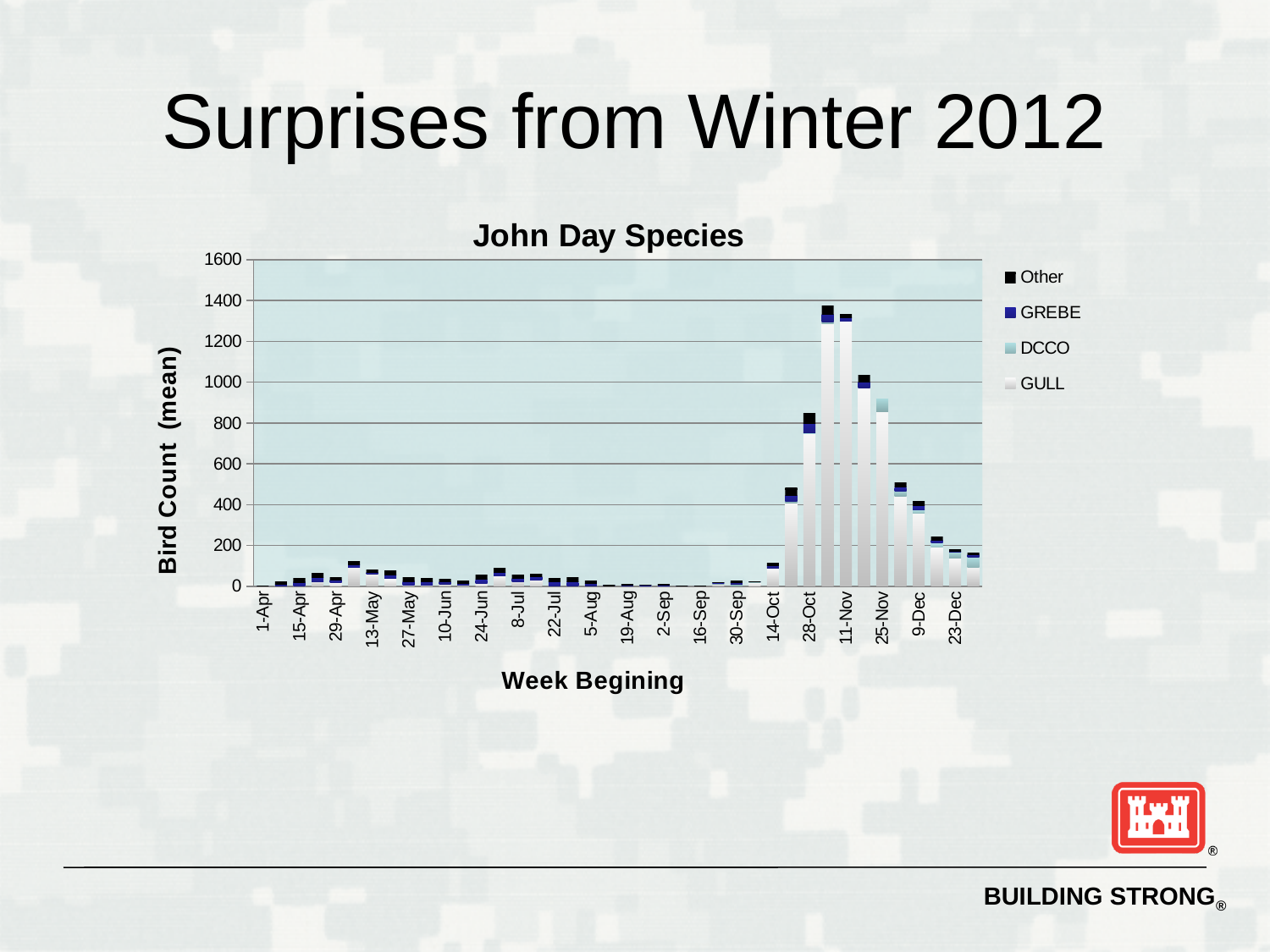
Is the total bird count for the week beginning 11-Nov greater or less than 1200? greater Which week has the larger total bird count, 11-Nov or 14-Oct? 11-Nov Is the total bird count for the week beginning 23-Dec greater or less than 400? less How many series does the legend of the John Day Species chart list? 4 Is the total bird count for the week beginning 14-Oct greater or less than 200? less What is the title of the chart? John Day Species Which week has the larger total bird count, 28-Oct or 9-Dec? 28-Oct Do the total bird counts rise or fall from 11-Nov to 23-Dec? fall What kind of chart is shown on the slide? Stacked bar chart What is the label of the vertical axis? Bird Count (mean)